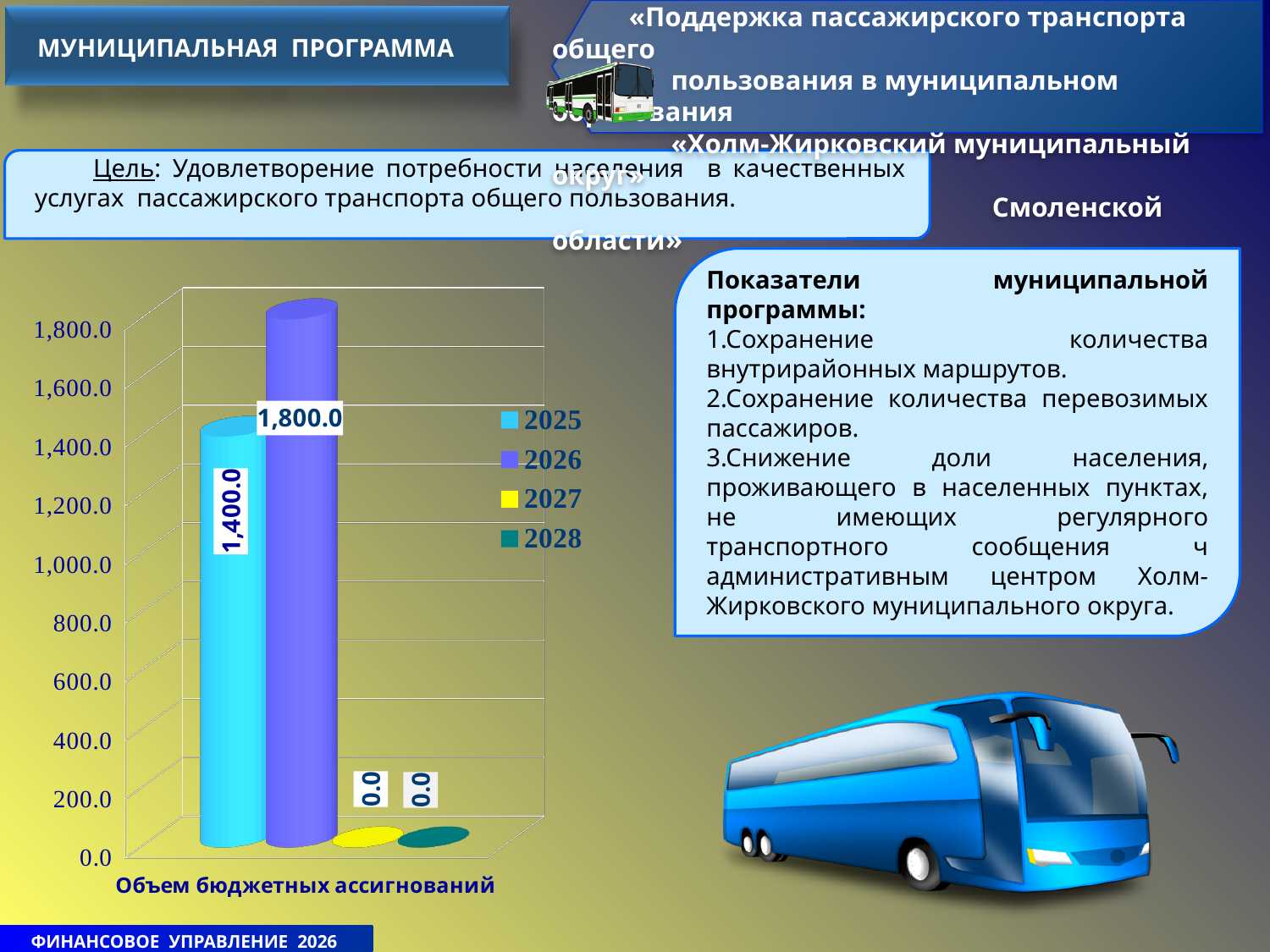
What is the value for the 2027 series in the chart? 0.0 What colour is the bar for the 2026 series in the chart? purple What is the category label shown under the chart's x axis? Объем бюджетных ассигнований What is the difference between the 2026 and 2025 values in the chart? 400.0 What kind of chart is shown on the slide? bar chart What is the value for the 2028 series in the chart? 0.0 Is the value for 2025 greater or less than 1,200.0? greater Which series has the highest value in the chart? 2026 What is the value for the 2025 series in the chart? 1,400.0 How many series does the chart legend list? 4 What is the value for the 2026 series in the chart? 1,800.0 Which is larger in the chart, the value for 2025 or the value for 2026? 2026